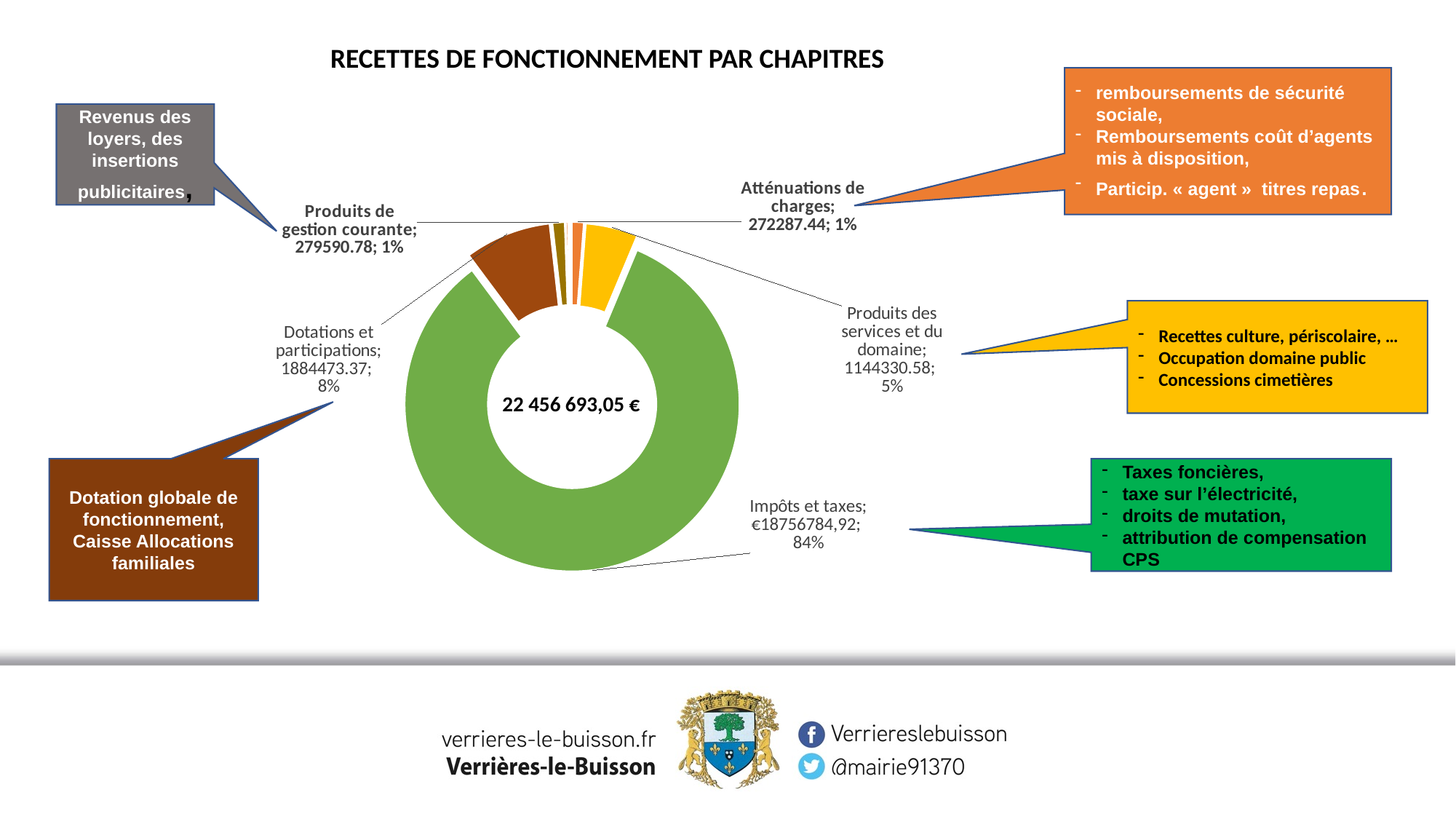
What kind of chart is shown on the slide? Doughnut (pie) chart How many labelled categories are shown in the chart? 5 What is the value shown for 'Dotations et participations'? 1884473.37 What is the value shown for 'Produits des services et du domaine'? 1144330.58 What is the difference between the values of 'Produits de gestion courante' and 'Atténuations de charges'? 7303.34 What is the value shown for 'Atténuations de charges'? 272287.44 What is the title of the chart? RECETTES DE FONCTIONNEMENT PAR CHAPITRES What total amount is shown in the centre of the doughnut chart? 22 456 693,05 € Which category has the largest share of the chart? Impôts et taxes Which is larger, 'Dotations et participations' or 'Produits des services et du domaine'? Dotations et participations What percentage share does 'Impôts et taxes' represent? 84% What percentage share does 'Dotations et participations' represent? 8%